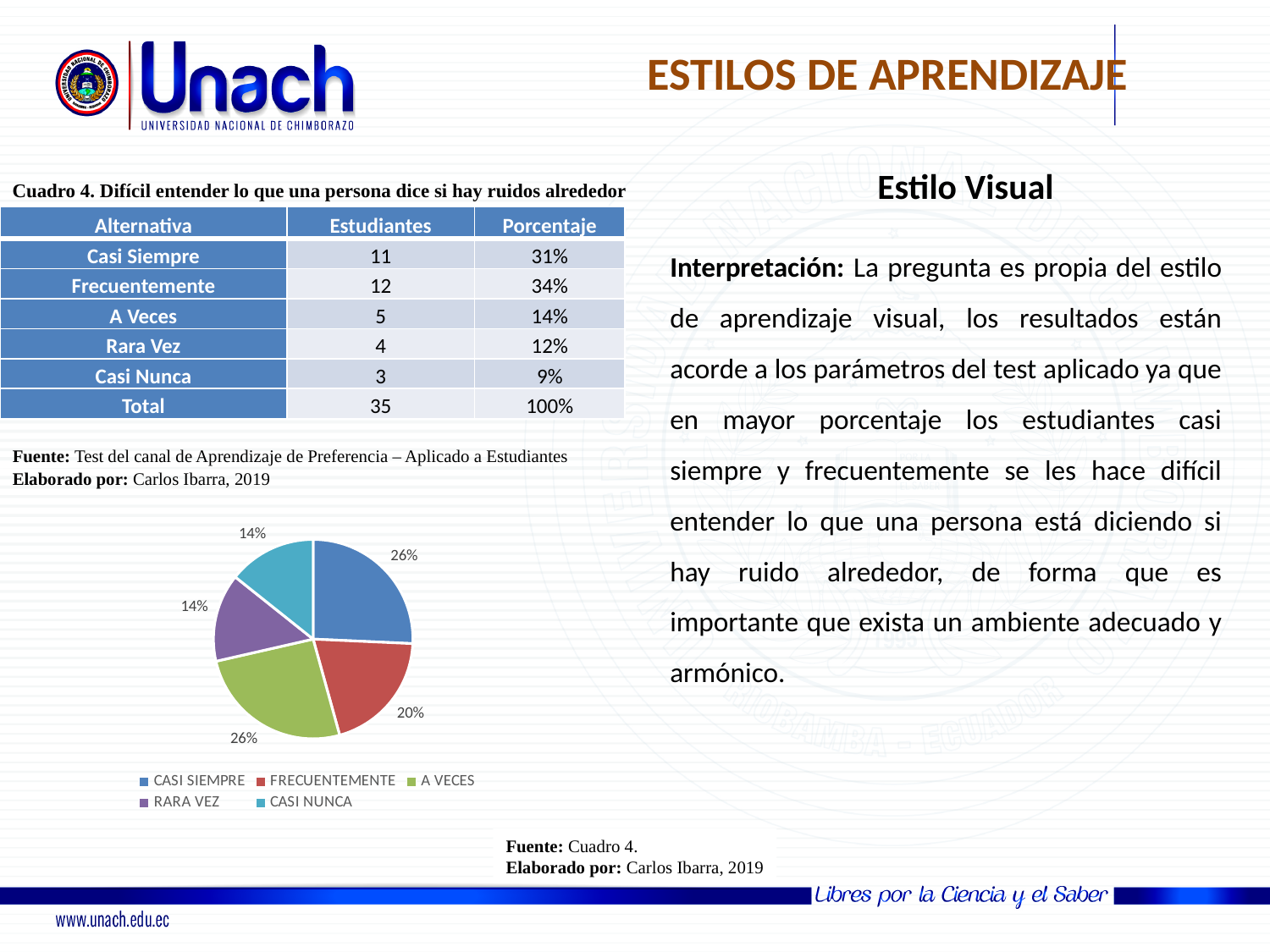
In the pie chart, what percentage is shown for the A VECES slice? 26% In the pie chart, what percentage is shown for the RARA VEZ slice? 14% In the pie chart, what percentage is shown for the FRECUENTEMENTE slice? 20% In the pie chart, which slice is larger: CASI SIEMPRE or FRECUENTEMENTE? CASI SIEMPRE In the pie chart, which slice is larger: FRECUENTEMENTE or RARA VEZ? FRECUENTEMENTE How many slices does the pie chart have? 5 What kind of chart is shown on the slide? pie chart How many entries does the pie chart legend list? 5 In the pie chart, what percentage is shown for the CASI SIEMPRE slice? 26% In the pie chart, what is the difference in percentage points between the CASI SIEMPRE slice and the FRECUENTEMENTE slice? 6 In the pie chart, what percentage is shown for the CASI NUNCA slice? 14% What colour is the CASI SIEMPRE slice in the pie chart? blue